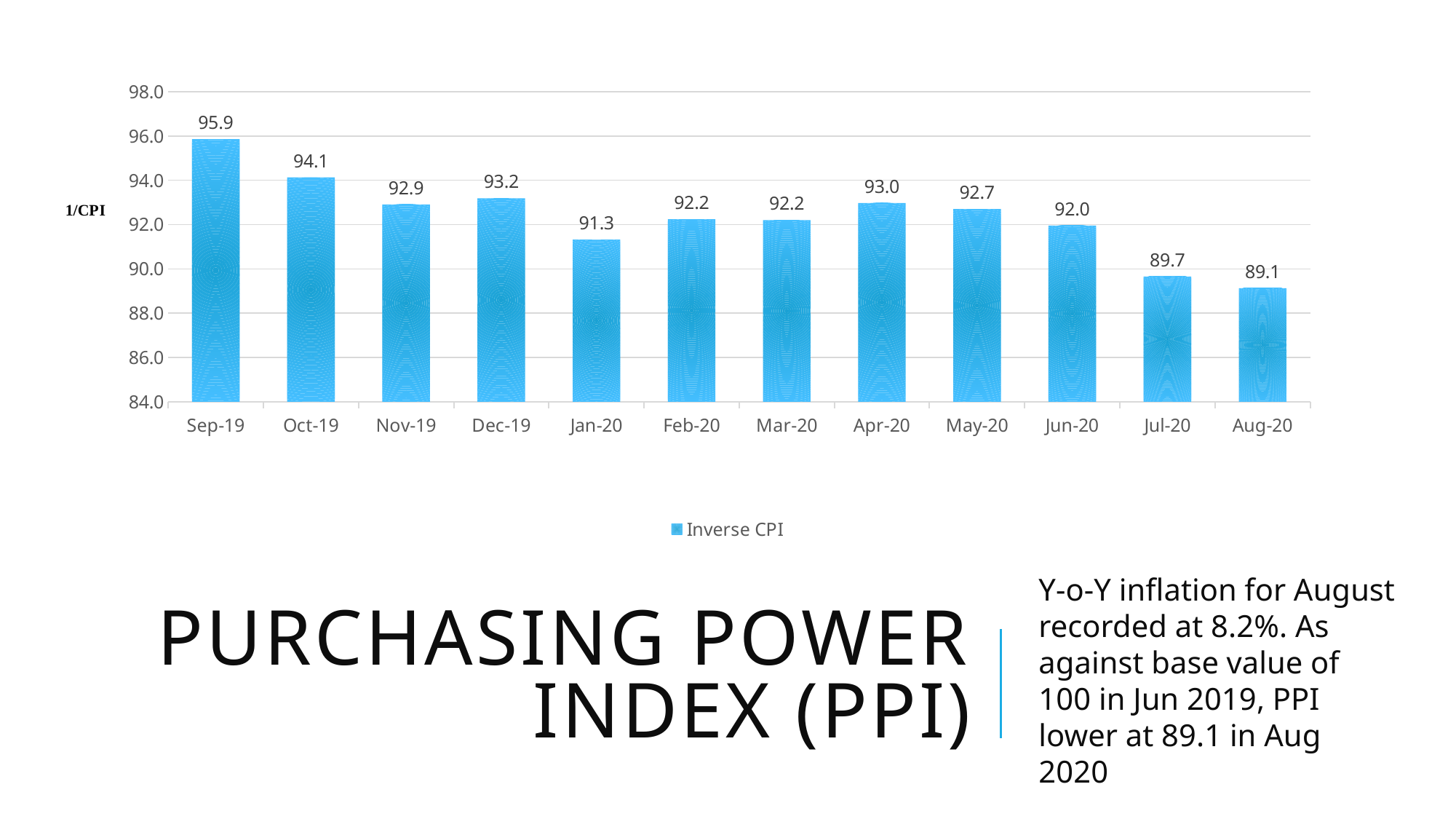
What is the difference between the Inverse CPI values for Jun-20 and Jul-20? 2.3 How many months are shown on the x axis of the chart? 12 What is the difference between the Inverse CPI values for Sep-19 and Aug-20? 6.8 What series name does the chart legend show? Inverse CPI What is the Inverse CPI value for Aug-20? 89.1 Which month has the highest Inverse CPI value? Sep-19 Which is larger, the Inverse CPI value for Dec-19 or for Apr-20? Dec-19 What kind of chart is shown on the slide? bar chart Which month has the lowest Inverse CPI value? Aug-20 Is the Inverse CPI value for Jul-20 greater or less than 90.0? less What is the Inverse CPI value for Jan-20? 91.3 What is the Inverse CPI value for Sep-19? 95.9